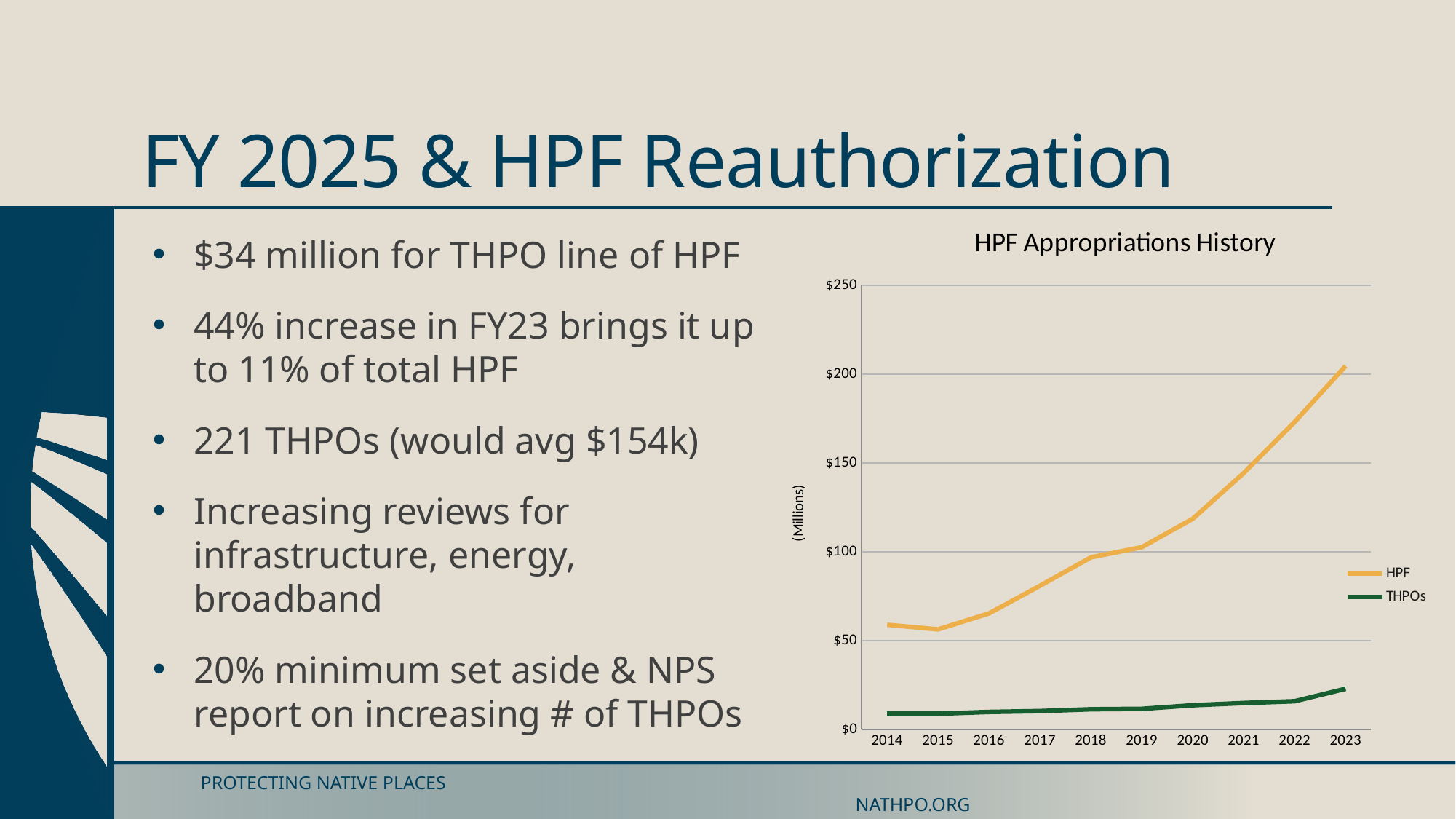
What kind of chart is shown on the slide? Line chart Is the HPF value for 2014 greater or less than $50? greater Does the HPF series generally rise or fall from 2015 to 2023? Rise In which year is the HPF series at its lowest? 2015 Is the HPF value for 2020 greater or less than $100? greater Which series has the larger value in 2023, HPF or THPOs? HPF Is the THPOs value for 2023 greater or less than $50? less In which year is the HPF series at its highest? 2023 How many series does the chart's legend list? 2 How many years are shown on the x axis of the chart? 10 What is the title of the chart? HPF Appropriations History